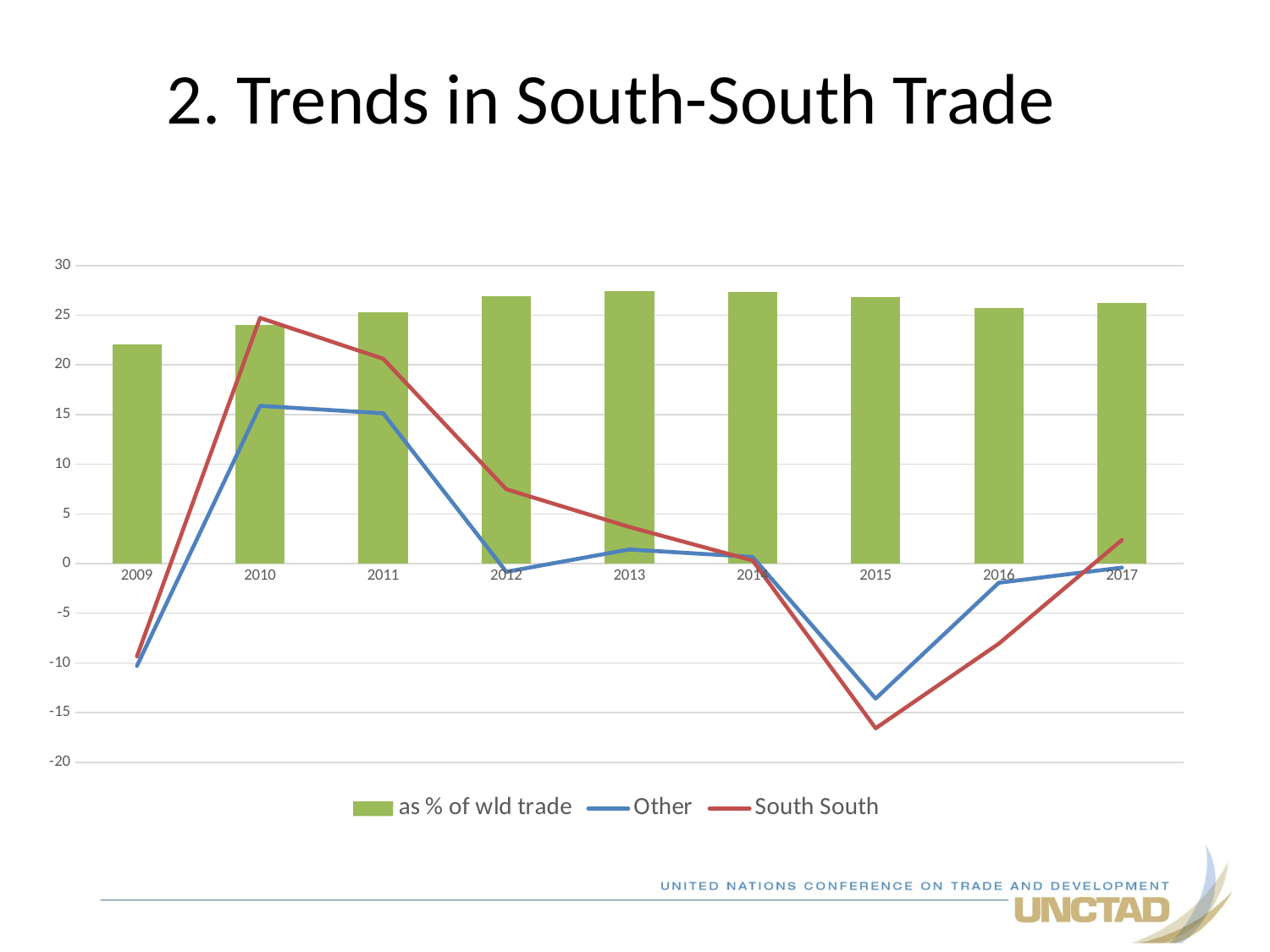
Which series is drawn as green bars? as % of wld trade In 2010, which is larger: the 'South South' value or the 'Other' value? South South Is the 'Other' value for 2015 greater or less than -10? less What kind of chart is this? Combined bar and line chart Is the 'South South' value for 2010 greater or less than 20? greater Is the 'as % of wld trade' bar for 2013 greater or less than 25? greater In which year does the 'Other' line reach its lowest value? 2015 In which year does the 'South South' line reach its highest value? 2010 Does the 'South South' line rise or fall between 2010 and 2015? Fall How many years are shown on the x axis? 9 How many series does the legend list? 3 Which year has the lowest bar for 'as % of wld trade'? 2009